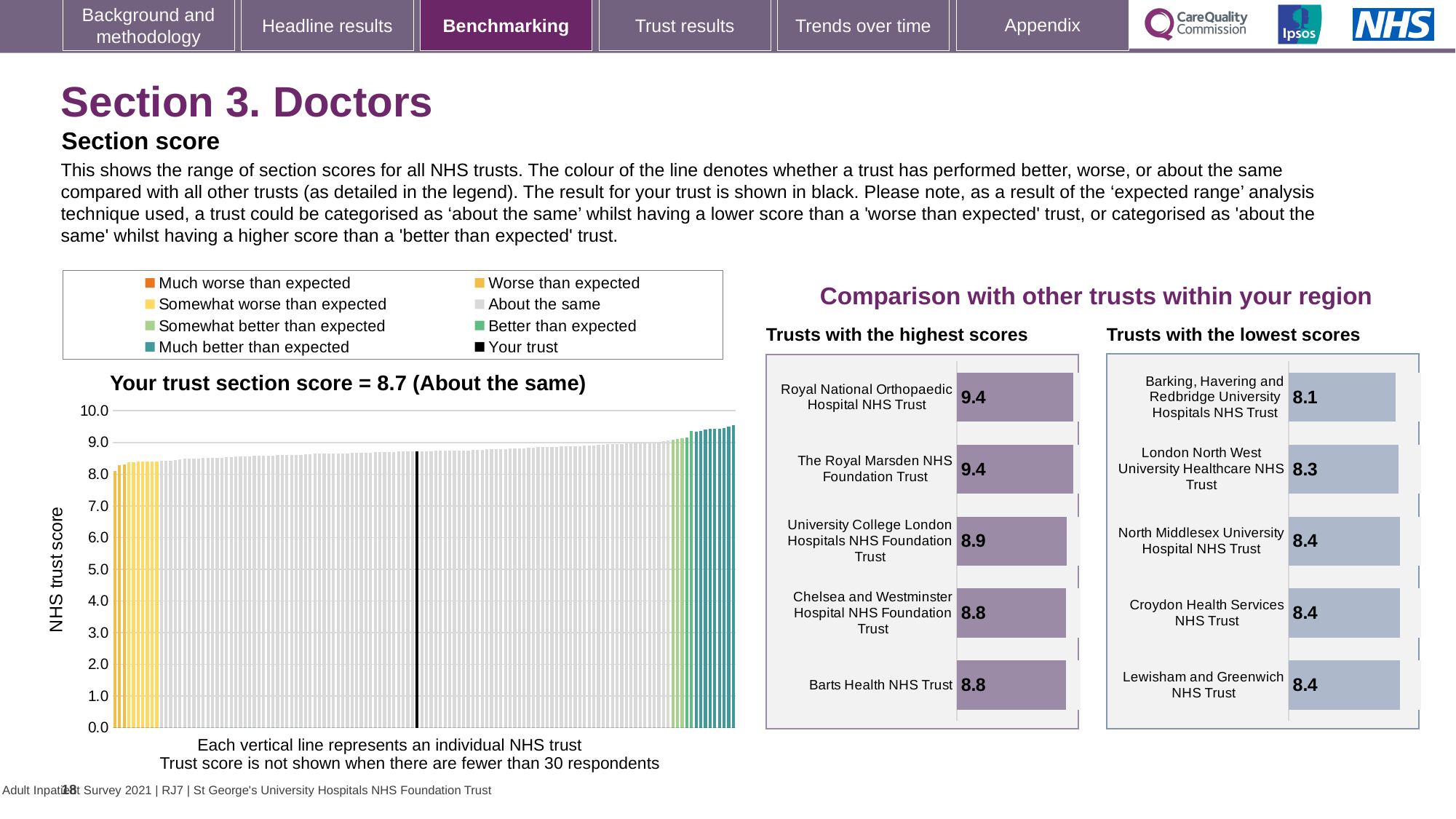
In the 'Trusts with the highest scores' chart, which has the higher score: University College London Hospitals NHS Foundation Trust or Chelsea and Westminster Hospital NHS Foundation Trust? University College London Hospitals NHS Foundation Trust What is the y-axis label of the chart on the left? NHS trust score In the 'Trusts with the lowest scores' chart, which trust has the lowest score? Barking, Havering and Redbridge University Hospitals NHS Trust In the 'Trusts with the highest scores' chart, what is the score for University College London Hospitals NHS Foundation Trust? 8.9 In the 'Trusts with the highest scores' chart, what is the score for Barts Health NHS Trust? 8.8 How many trusts are listed in the 'Trusts with the lowest scores' chart? 5 In the 'Trusts with the lowest scores' chart, what is the difference between the score for North Middlesex University Hospital NHS Trust and the score for Barking, Havering and Redbridge University Hospitals NHS Trust? 0.3 According to the title of the chart on the left, what is your trust's section score? 8.7 In the 'Trusts with the lowest scores' chart, what is the score for London North West University Healthcare NHS Trust? 8.3 What kind of chart is the 'Trusts with the highest scores' chart? Bar chart In the chart on the left, is the value for your trust (the black line) greater or less than 8.0? greater In the 'Trusts with the highest scores' chart, what is the difference between the score for Royal National Orthopaedic Hospital NHS Trust and the score for Barts Health NHS Trust? 0.6